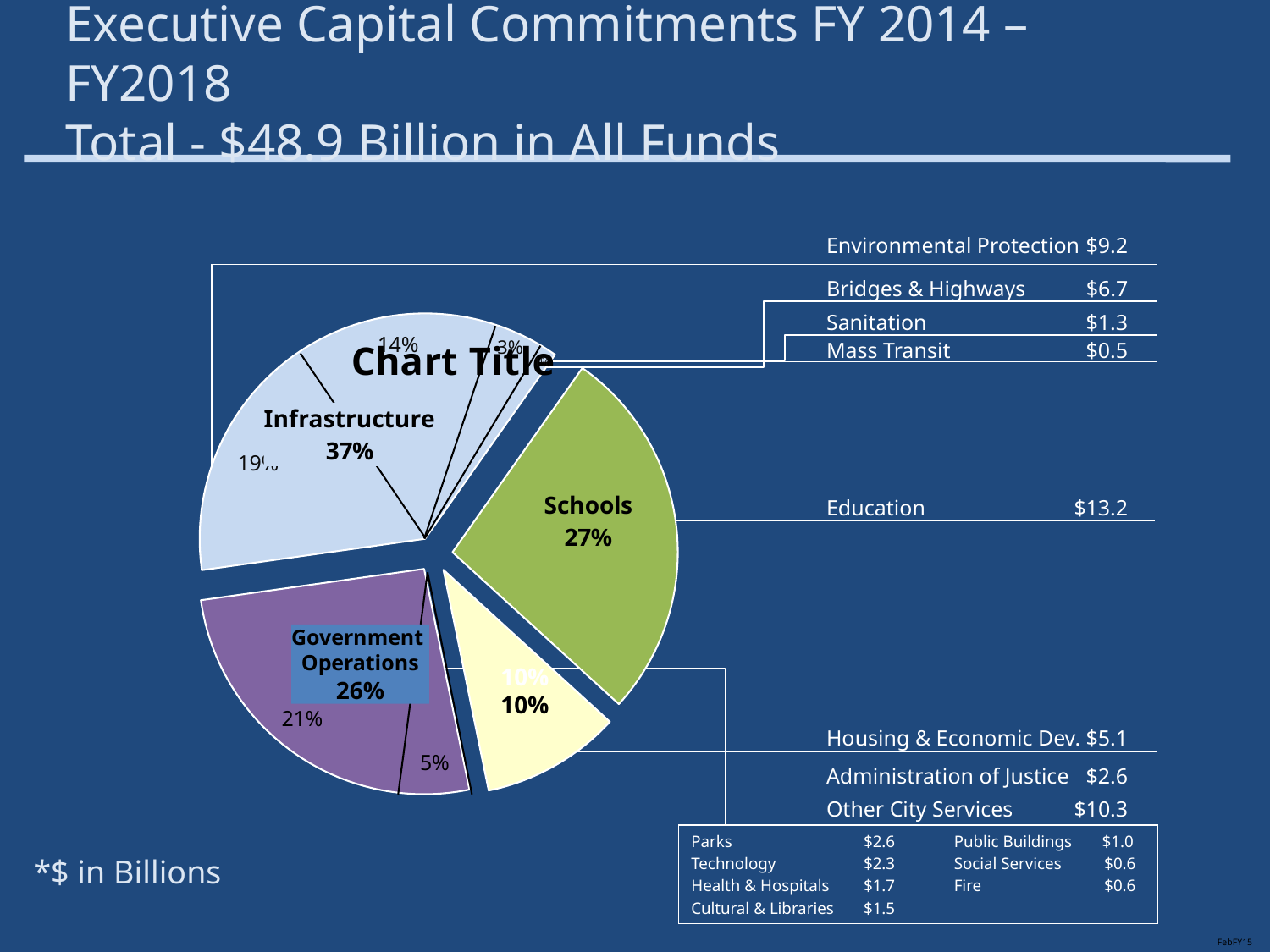
What percentage of the pie is labelled for Government Operations? 26% What percentage of the pie is labelled for Infrastructure? 37% What is the combined share of the Infrastructure and Schools slices? 64% Which named slice of the pie has the largest share? Infrastructure Which is larger, the Schools slice or the Government Operations slice? Schools By how many percentage points does the Infrastructure share exceed the Schools share? 10 percentage points What title text is printed on the pie chart? Chart Title What type of chart is shown on the slide? pie chart What percentage is labelled on the yellow slice of the pie? 10% How many slices does the pie chart have? 4 What percentage of the pie is labelled for Schools? 27% What colour is the Schools slice of the pie? green